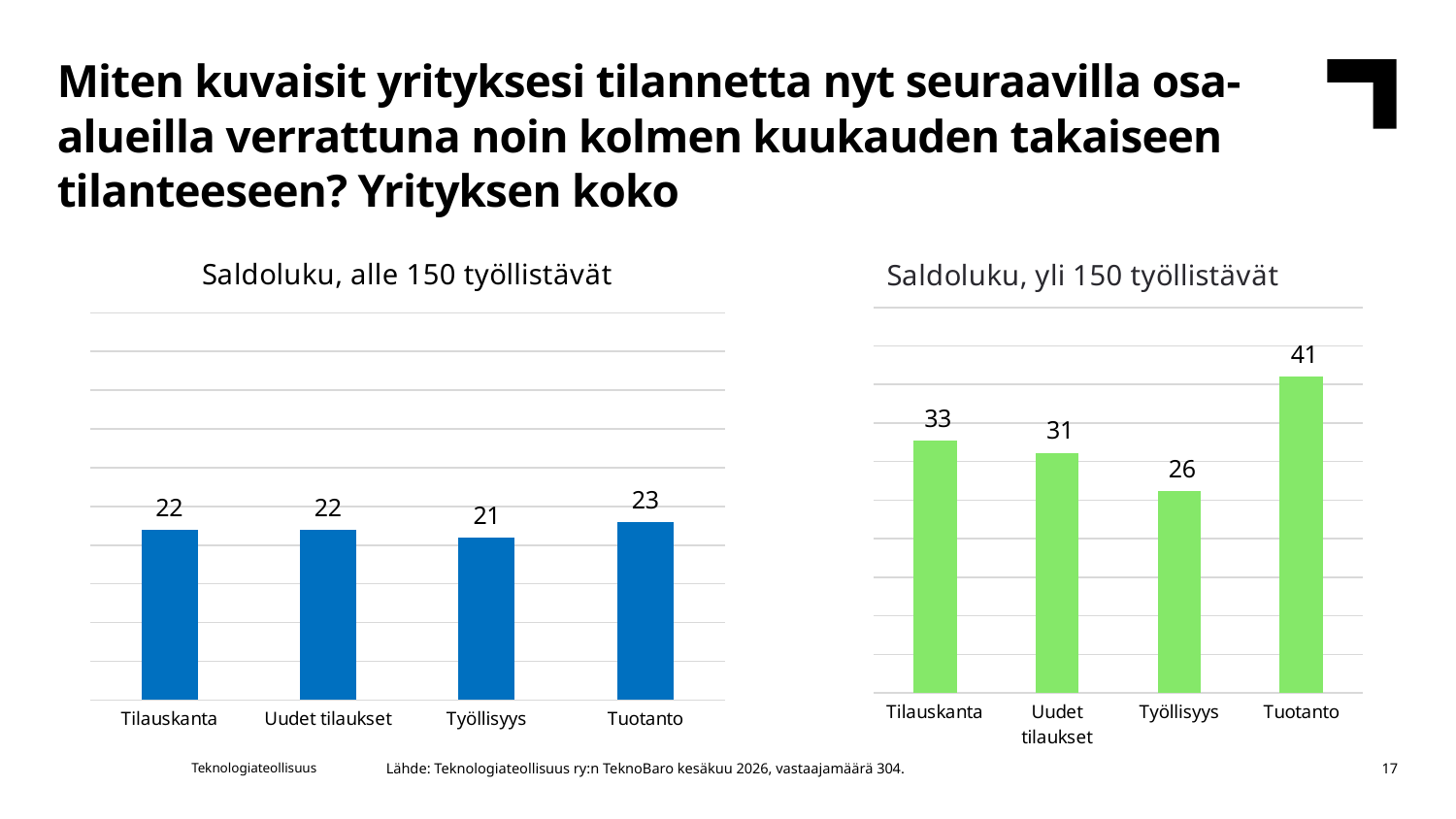
In the chart titled "Saldoluku, yli 150 työllistävät", which category has the highest value? Tuotanto In the chart titled "Saldoluku, yli 150 työllistävät", which is larger, the value for Tilauskanta or the value for Uudet tilaukset? Tilauskanta In the chart titled "Saldoluku, alle 150 työllistävät", what is the value for Tuotanto? 23 In the chart titled "Saldoluku, alle 150 työllistävät", what is the difference between the values for Tuotanto and Työllisyys? 2 What kind of chart is the chart titled "Saldoluku, yli 150 työllistävät"? Bar chart Which chart on the slide uses green bars? Saldoluku, yli 150 työllistävät In the chart titled "Saldoluku, yli 150 työllistävät", what is the value for Tilauskanta? 33 In the chart titled "Saldoluku, yli 150 työllistävät", what is the value for Työllisyys? 26 In the chart titled "Saldoluku, alle 150 työllistävät", what is the value for Uudet tilaukset? 22 In the chart titled "Saldoluku, yli 150 työllistävät", what is the difference between the values for Tuotanto and Työllisyys? 15 How many categories are shown in the chart titled "Saldoluku, alle 150 työllistävät"? 4 In the chart titled "Saldoluku, alle 150 työllistävät", which category has the lowest value? Työllisyys